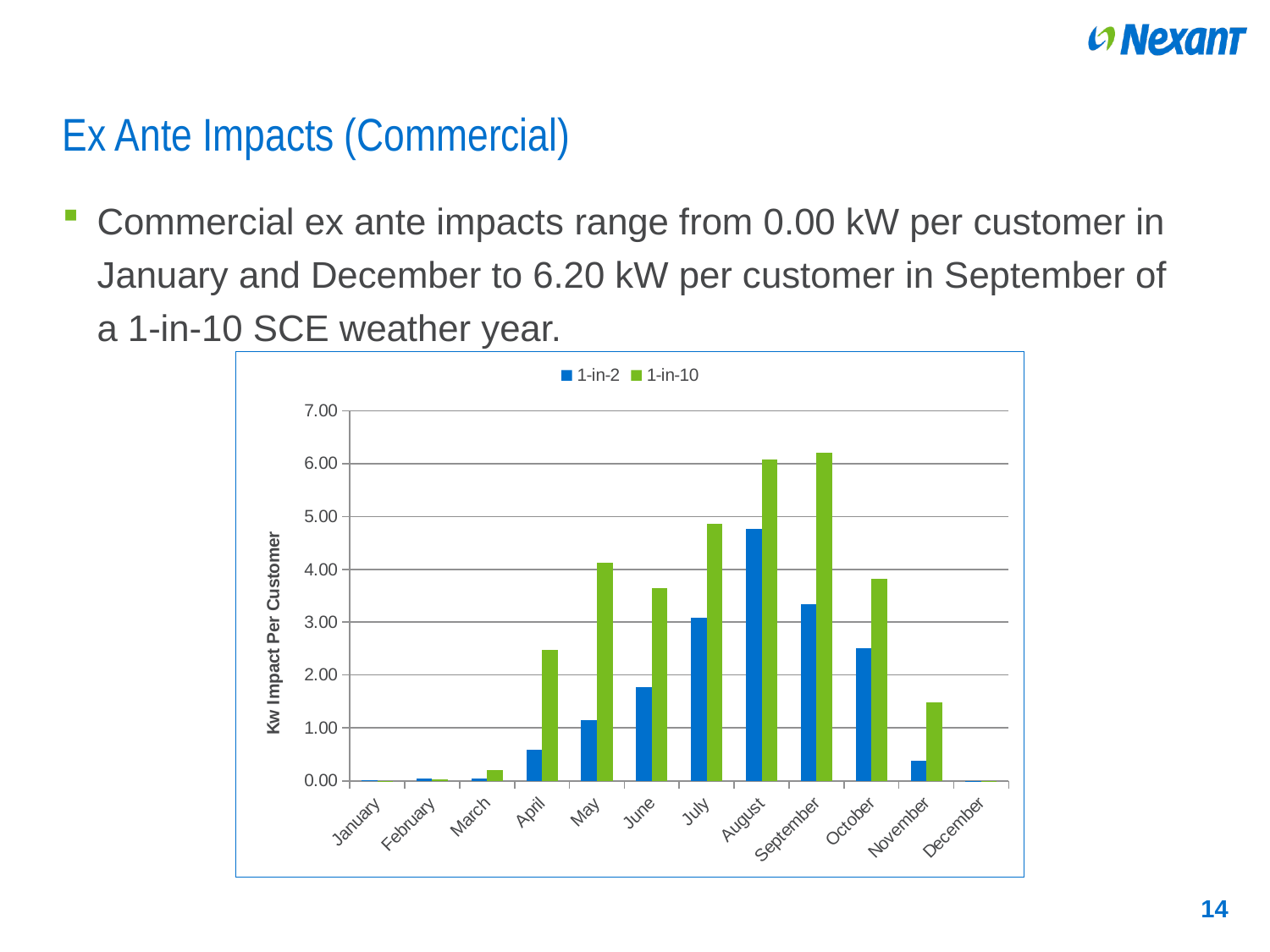
Is the 1-in-2 value for June greater or less than 2.00? less What kind of chart is shown on the slide? bar chart What is the 1-in-10 kW impact per customer in September? 6.20 kW Which is larger, the 1-in-2 value for August or the 1-in-2 value for September? August Is the 1-in-2 value for August greater or less than 4.00? greater Do the 1-in-2 values rise or fall from April through August? rise How many series does the chart's legend list? 2 How many months are shown along the x axis of the chart? 12 Is the 1-in-10 value for April greater or less than 2.00? greater In which month is the 1-in-2 value highest? August In which month is the 1-in-10 value highest? September